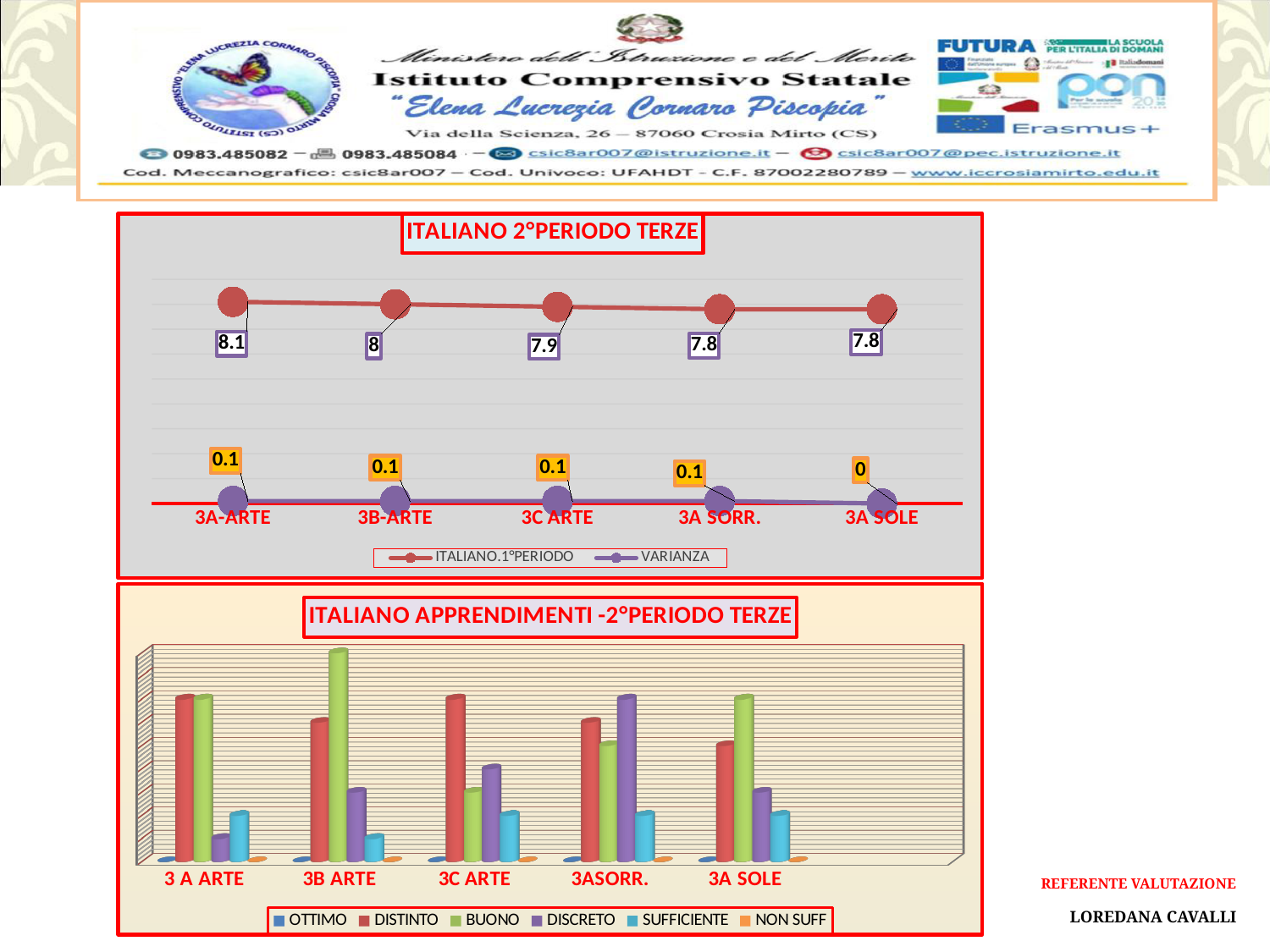
In the top chart 'ITALIANO 2°PERIODO TERZE', what is the difference between the ITALIANO.1°PERIODO values for 3A-ARTE and 3A SOLE? 0.3 In the top chart 'ITALIANO 2°PERIODO TERZE', which class has the highest ITALIANO.1°PERIODO value? 3A-ARTE How many series does the legend of the bottom chart 'ITALIANO APPRENDIMENTI -2°PERIODO TERZE' list? 6 In the top chart 'ITALIANO 2°PERIODO TERZE', what is the ITALIANO.1°PERIODO value for 3C ARTE? 7.9 In the top chart 'ITALIANO 2°PERIODO TERZE', which is larger: the ITALIANO.1°PERIODO value for 3B-ARTE or for 3A SORR.? 3B-ARTE What kind of chart is the bottom chart 'ITALIANO APPRENDIMENTI -2°PERIODO TERZE'? bar chart How many series does the legend of the top chart 'ITALIANO 2°PERIODO TERZE' list? 2 In the bottom chart 'ITALIANO APPRENDIMENTI -2°PERIODO TERZE', which series has the tallest bar for 3B ARTE? BUONO In the top chart 'ITALIANO 2°PERIODO TERZE', do the ITALIANO.1°PERIODO values rise or fall from 3A-ARTE to 3A SOLE? fall In the top chart 'ITALIANO 2°PERIODO TERZE', what is the VARIANZA value for 3A SOLE? 0 In the top chart 'ITALIANO 2°PERIODO TERZE', what is the ITALIANO.1°PERIODO value for 3A-ARTE? 8.1 How many classes are shown on the x axis of the bottom chart 'ITALIANO APPRENDIMENTI -2°PERIODO TERZE'? 5